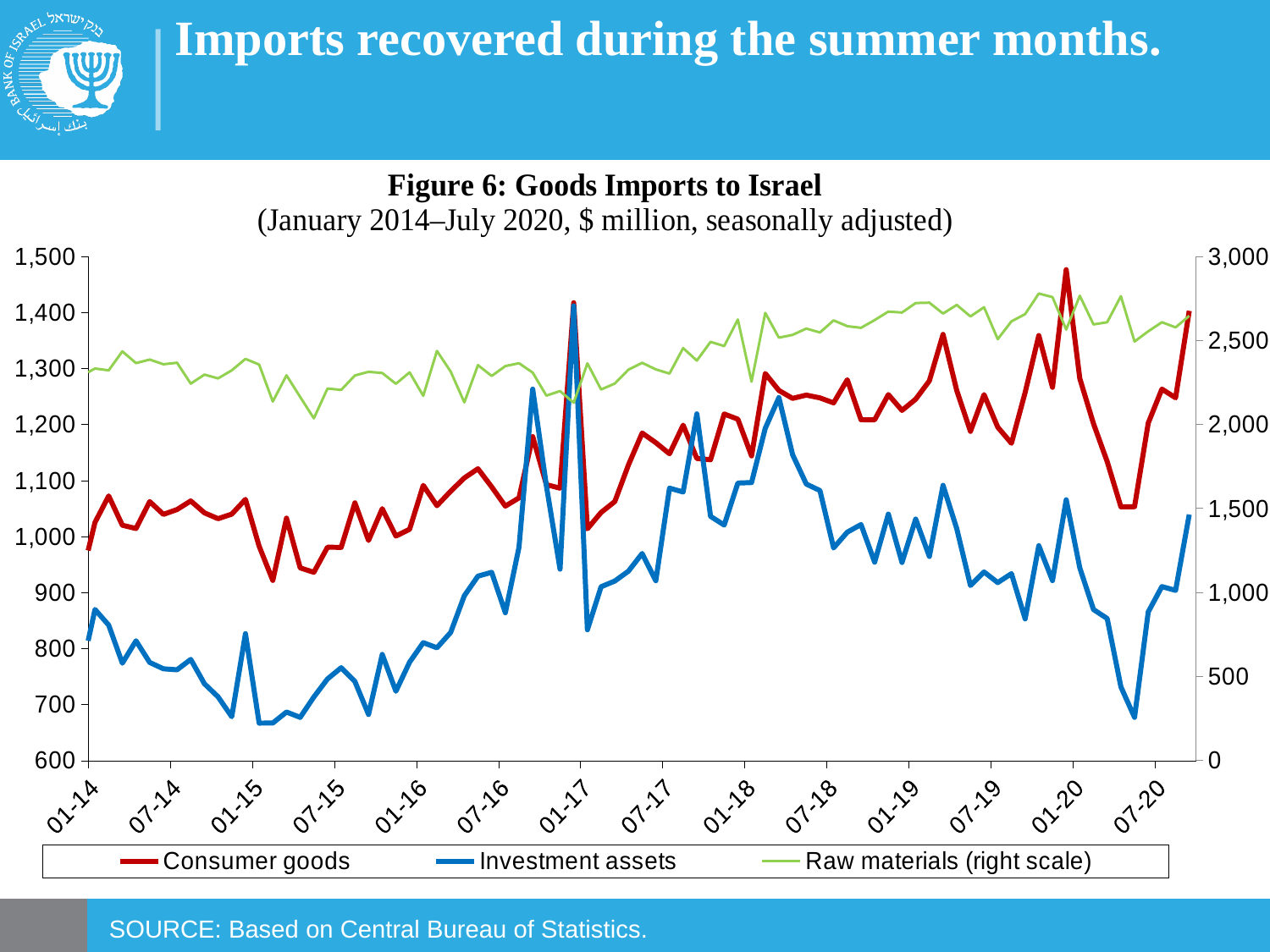
Which series is plotted on the right scale? Raw materials Is the lowest value of Investment assets in 2020 greater or less than 800? less Is the peak value of Consumer goods near 01-20 greater or less than 1,400? greater Is the value for Raw materials (right scale) at 01-14 greater or less than 2,000? greater At 01-14, which series has the higher value on the left scale: Consumer goods or Investment assets? Consumer goods How many series does the legend list? 3 Do the values for Investment assets rise or fall between 01-14 and 01-15? fall Do the values for Consumer goods rise or fall between 01-20 and the low point in mid-2020? fall What kind of chart is shown on the slide? line chart What is the title of the figure on the slide? Figure 6: Goods Imports to Israel